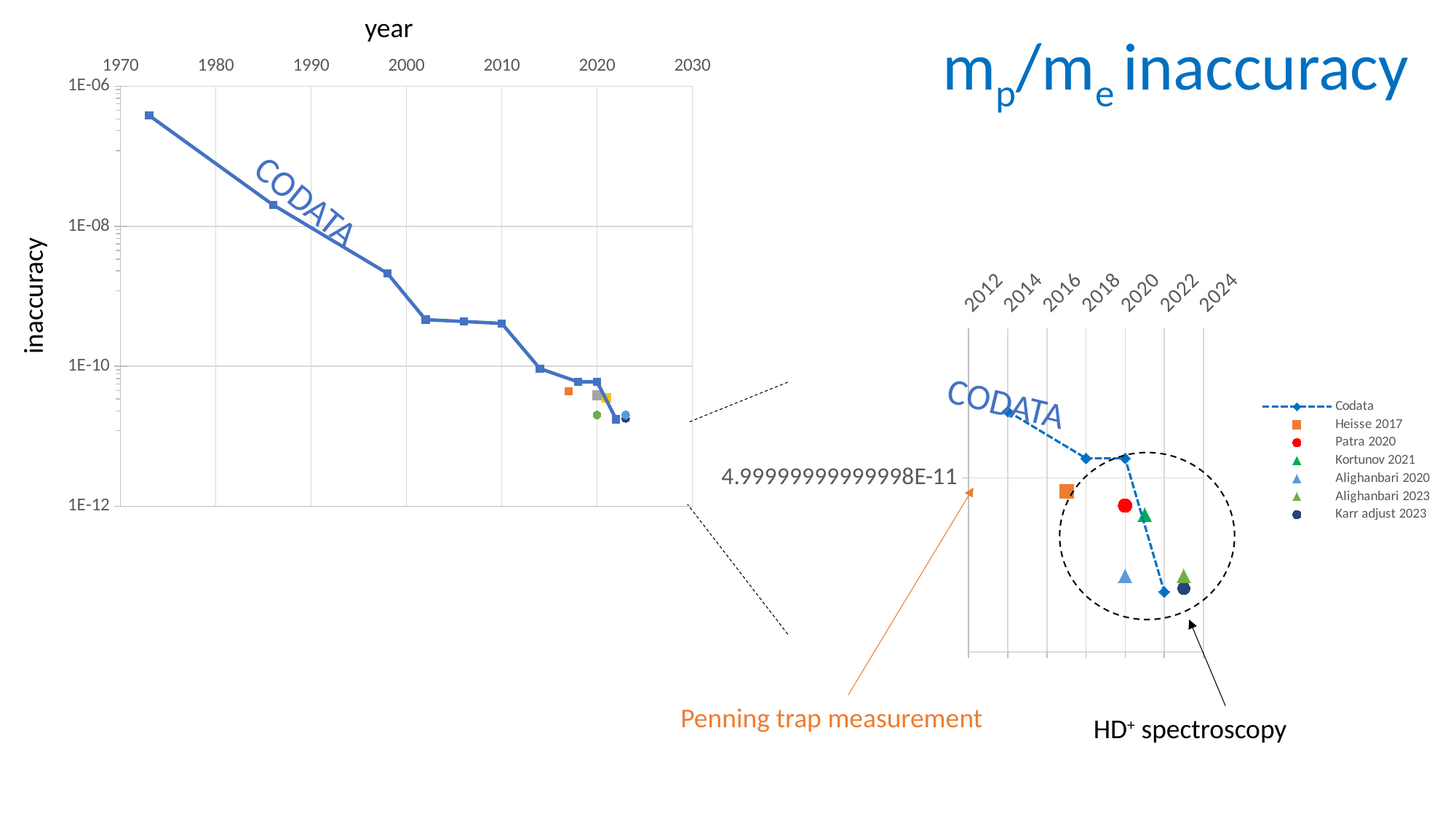
In the left chart, what kind of chart is it? line chart In the left chart, is the CODATA value around the year 2022 greater or less than 1E-10? less In the left chart, is the CODATA value for the earliest point (around 1973) greater or less than 1E-08? greater What is the title shown on the slide for the charts? mp/me inaccuracy In the left chart, what is the label of the x axis? year In the right (zoomed) chart, how many series does the legend list? 7 In the right (zoomed) chart, which has the higher inaccuracy, Heisse 2017 or Alighanbari 2020? Heisse 2017 In the left chart, does the CODATA inaccuracy rise or fall as the year increases? fall In the right (zoomed) chart, which series is plotted with a red circle marker? Patra 2020 In the right (zoomed) chart, does the Codata series rise or fall from 2014 to 2022? fall In the right (zoomed) chart, which has the higher inaccuracy, Kortunov 2021 or Alighanbari 2023? Kortunov 2021 In the left chart, is the CODATA value around the year 2000 greater or less than 1E-08? less